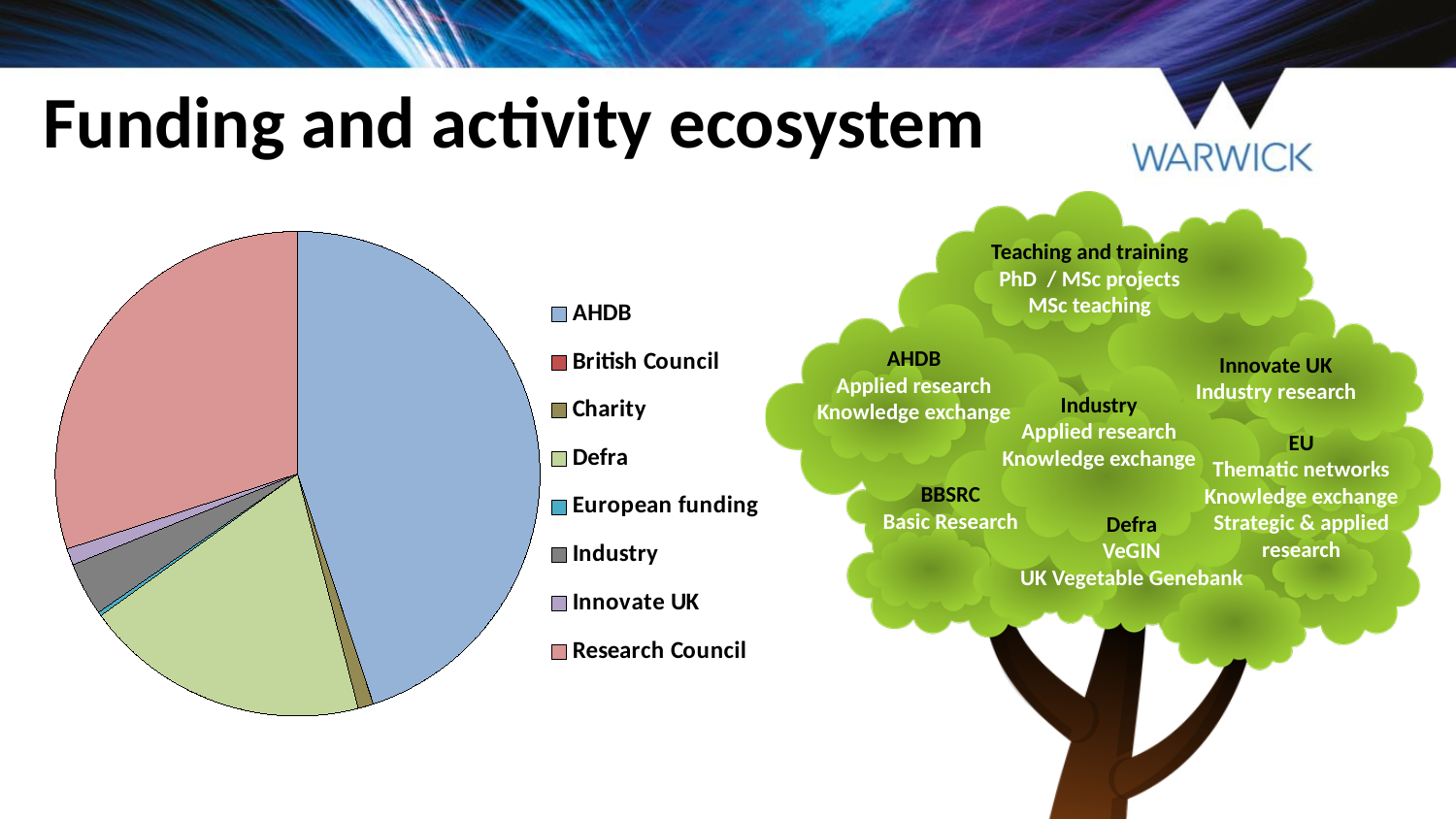
Which slice is larger in the pie chart, AHDB or Defra? AHDB Which slice is larger in the pie chart, Research Council or Industry? Research Council What kind of chart is shown on the left of the slide? pie chart Which category has the largest slice of the pie chart? AHDB How many categories does the pie chart's legend list? 8 Which slice is larger in the pie chart, Industry or European funding? Industry Which legend entry is listed last in the pie chart's legend? Research Council What colour is the AHDB slice in the pie chart? blue